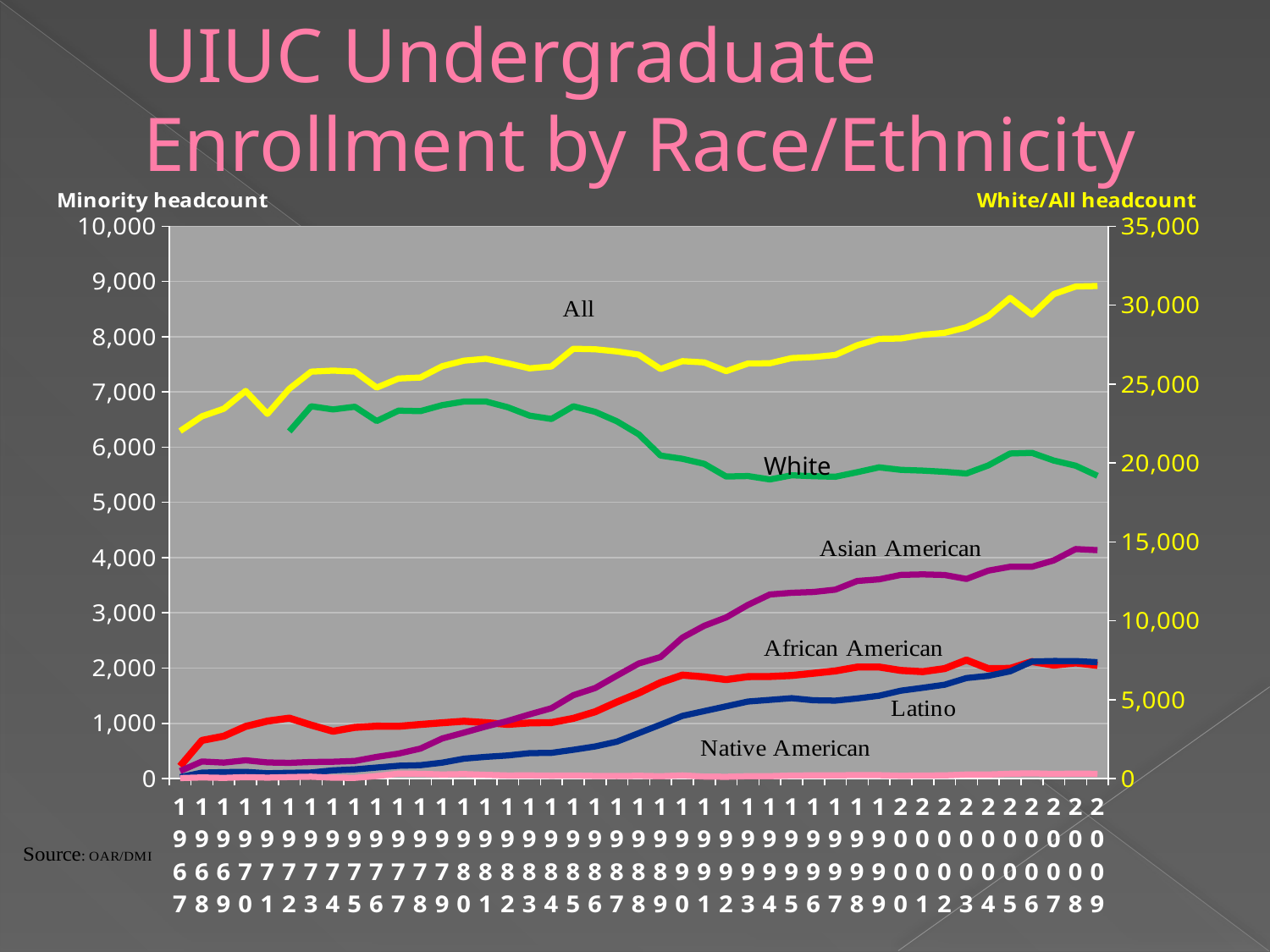
What kind of chart is shown on the slide? Line chart How many series are plotted on the chart? 6 Does the Asian American headcount generally rise or fall from 1967 to 2009? rise In 2009, which is larger: the Asian American headcount or the African American headcount? Asian American What is the title of the left vertical axis? Minority headcount Which minority series has the highest value in 2009? Asian American Is the White headcount in 1980 greater or less than 20,000 on the right axis? greater Is the Native American headcount in 2009 greater or less than 1,000 on the left axis? less Which series has the lowest values across the chart? Native American Is the Asian American headcount in 2009 greater or less than 3,000 on the left axis? greater How many years are shown along the x axis of the chart? 43 What source is cited for the chart? OAR/DMI